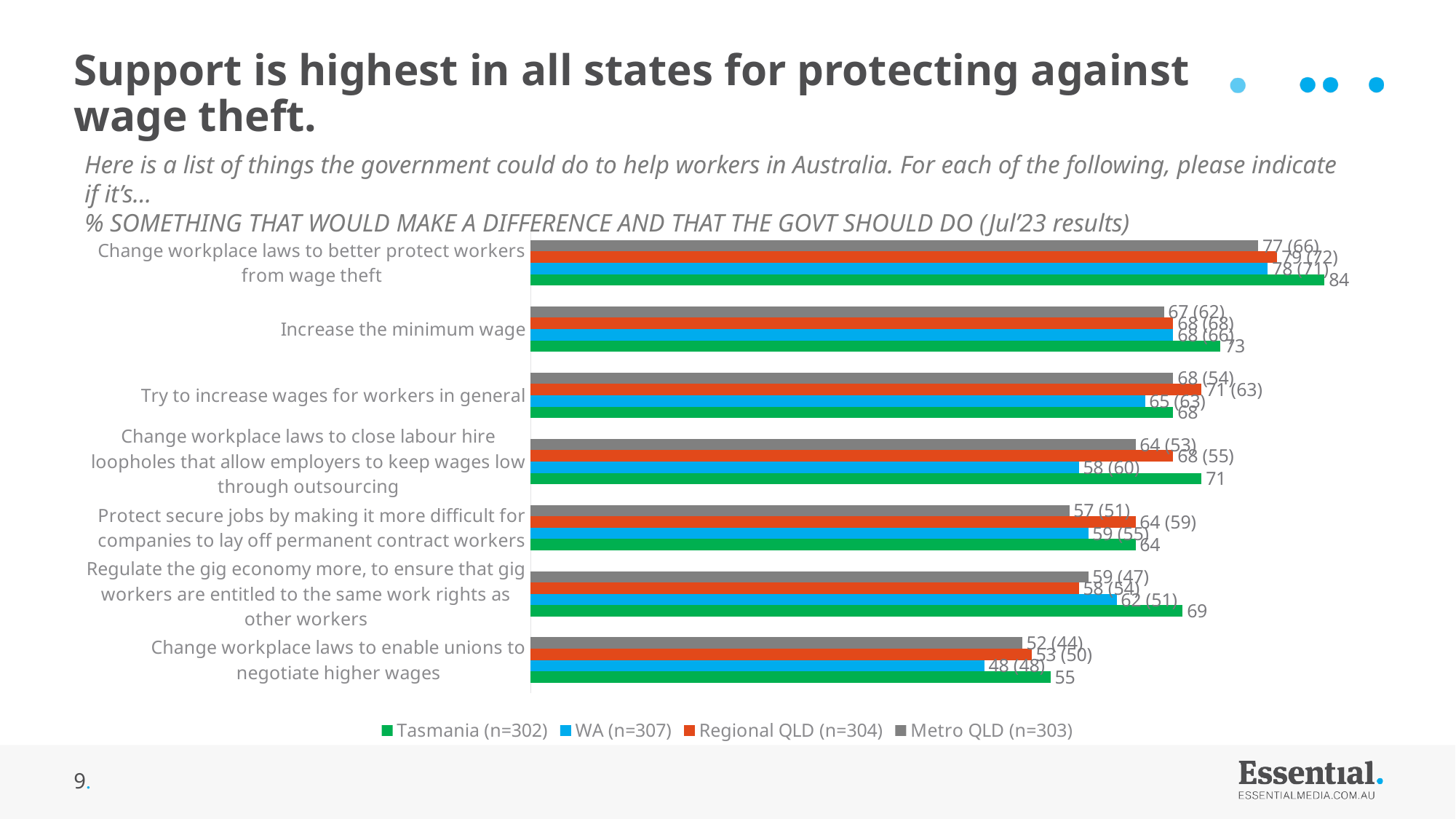
What label is printed on the Metro QLD bar for 'Change workplace laws to enable unions to negotiate higher wages'? 52 (44) How many categories (government actions) are shown on the chart? 7 What is the Tasmania value for 'Change workplace laws to better protect workers from wage theft'? 84 What kind of chart is shown on the slide? Bar chart What sample size does the legend give for WA? n=307 What label is printed on the Regional QLD bar for 'Protect secure jobs by making it more difficult for companies to lay off permanent contract workers'? 64 (59) What is the difference between the Tasmania value for protecting against wage theft (84) and the Tasmania value for enabling unions to negotiate higher wages (55)? 29 Which category has the lowest Tasmania value? Change workplace laws to enable unions to negotiate higher wages For 'Regulate the gig economy more', which is larger: the Tasmania value or the Metro QLD value? Tasmania How many series does the legend list? 4 Which category has the highest Tasmania value? Change workplace laws to better protect workers from wage theft For 'Change workplace laws to close labour hire loopholes', which is larger: the Tasmania value or the WA value? Tasmania